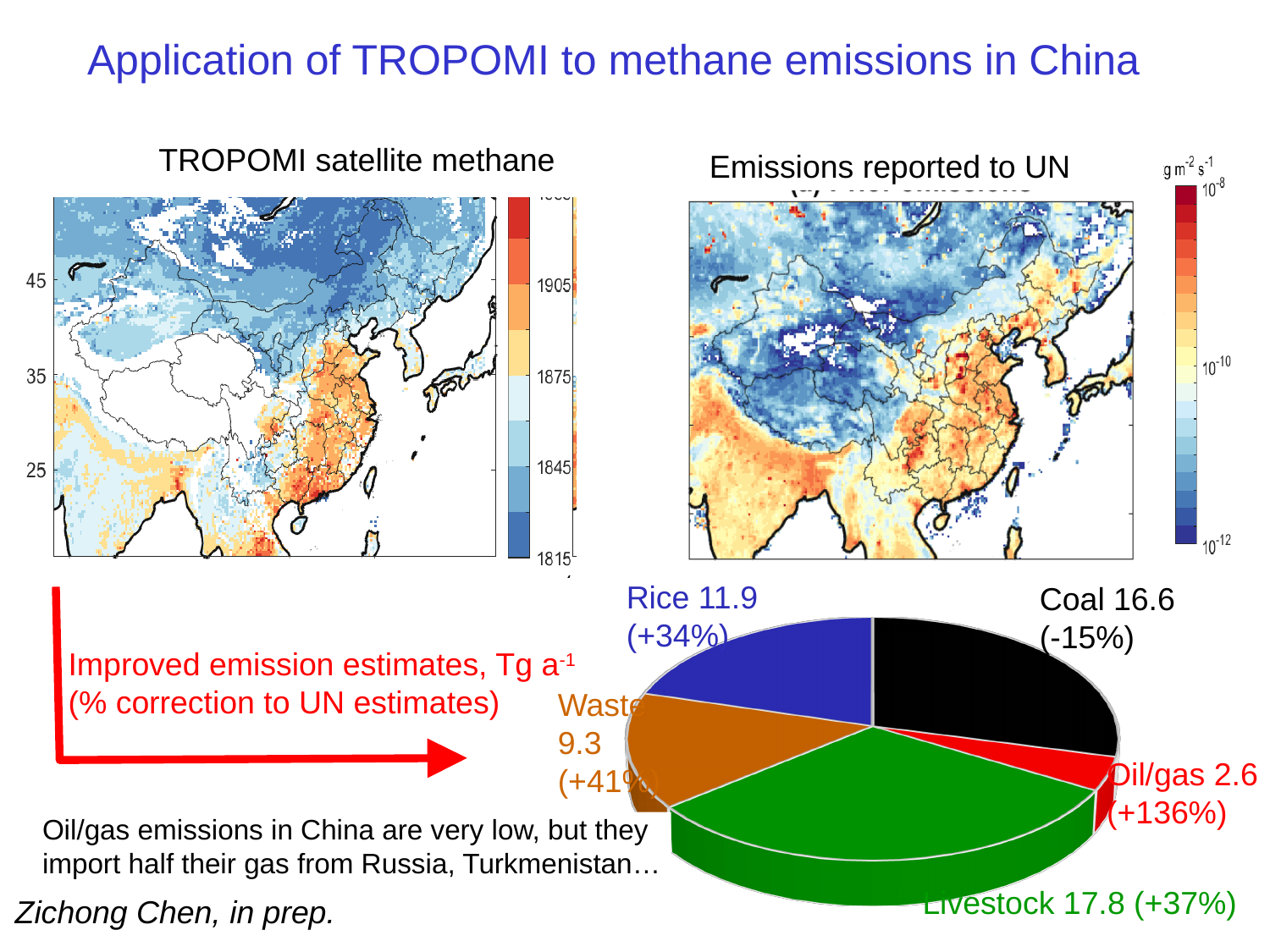
In the pie chart, which is larger, the emission estimate for Rice or for Waste? Rice In the pie chart, which source has the smallest emission estimate? Oil/gas How many sources are shown in the pie chart? 5 In the pie chart, what percentage correction to the UN estimate is shown for Coal? -15% In the pie chart, what colour is the Livestock slice? green In the pie chart, what is the emission estimate for Coal? 16.6 In the pie chart, what is the emission estimate for Livestock? 17.8 In the pie chart, what is the difference between the Livestock and Coal emission estimates? 1.2 In the pie chart, which source has the largest emission estimate? Livestock In the pie chart, what is the difference between the Rice and Waste emission estimates? 2.6 What kind of chart is shown at the bottom right of the slide? pie chart In the pie chart, what percentage correction to the UN estimate is shown for Oil/gas? +136%